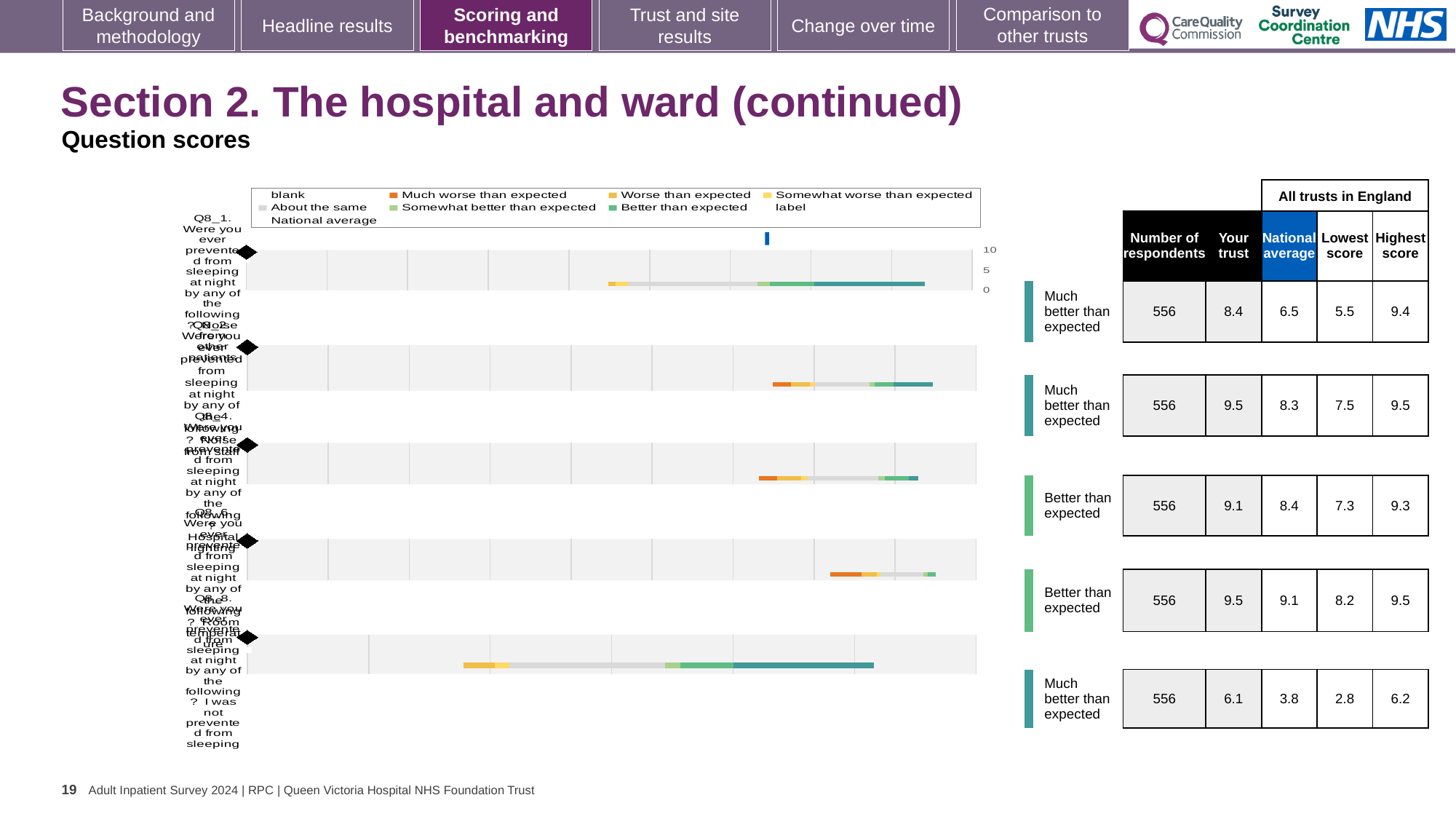
How many question rows (bars) are plotted in the chart? 5 What is the difference between the 'Your trust' score and the national average for the first row (Q8_1)? 1.9 What benchmark category is shown for the third row (Q8_4)? Better than expected What is the lowest score among all trusts in England for the second row (Q8_2)? 7.5 What is the number of respondents for the second row (Q8_2)? 556 Which legend entry is shown in dark orange? Much worse than expected What is the highest score among all trusts in England for the last row (Q8_8)? 6.2 What is the national average for the last row (Q8_8)? 3.8 For the third row (Q8_4), which is larger: the 'Your trust' score or the national average? Your trust Which row has the lowest 'Your trust' score? Q8_8 (the last row) What is the 'Your trust' score for the first row (Q8_1)? 8.4 What kind of chart is shown on the slide? bar chart